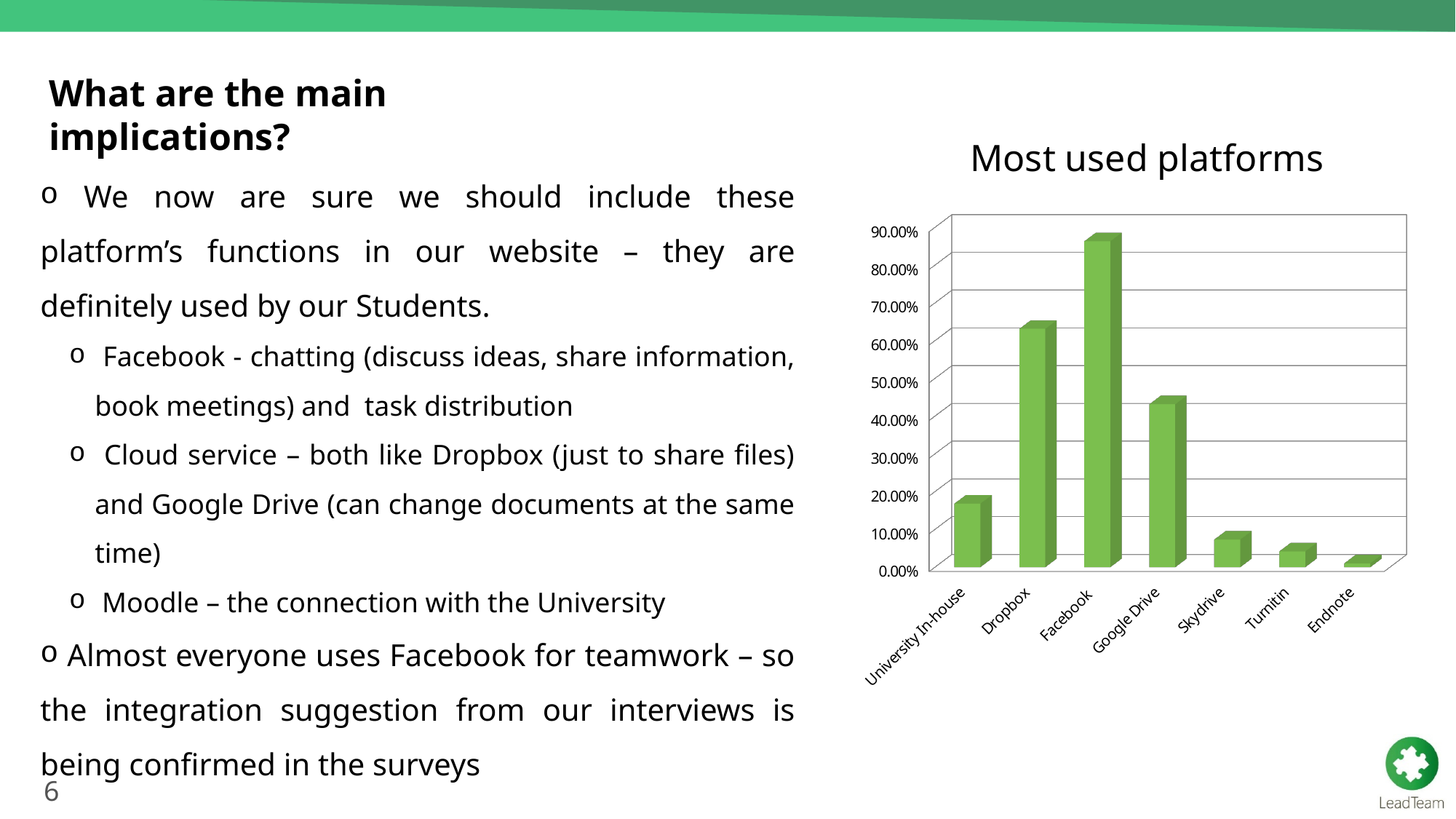
What is the title of the chart on the slide? Most used platforms Which platform has the lowest value in the chart? Endnote Is the value for University In-house greater or less than 20.00%? less Is the value for Facebook greater or less than 80.00%? greater Is the value for Skydrive greater or less than 10.00%? less Which has a larger value, Dropbox or Google Drive? Dropbox How many platforms are shown on the x axis of the chart? 7 Which has a larger value, University In-house or Skydrive? University In-house Which platform has the highest value in the chart? Facebook What kind of chart is shown on the slide? bar chart